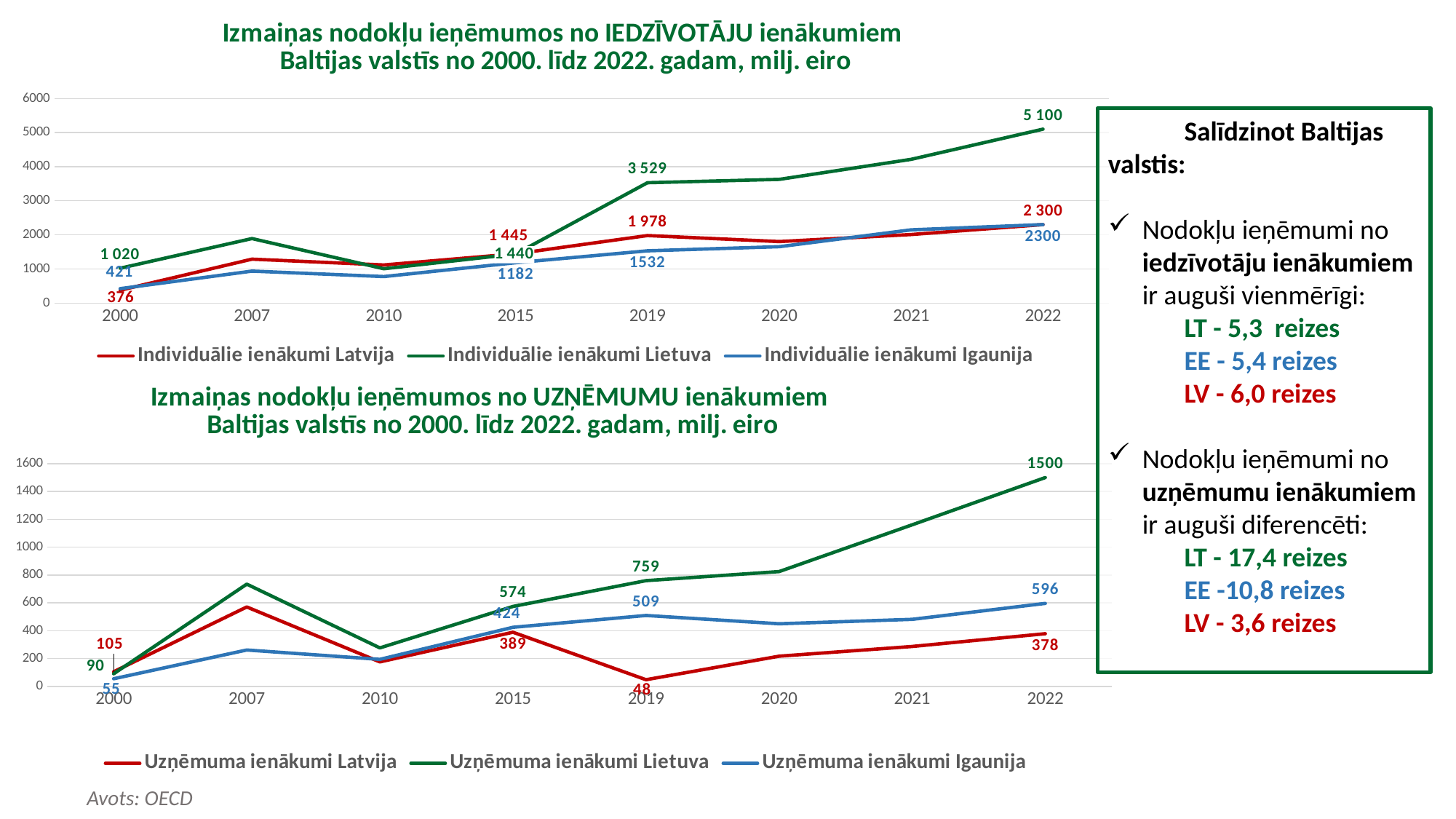
In the bottom chart (UZŅĒMUMU ienākumiem), what is the value for Uzņēmuma ienākumi Latvija in 2019? 48 In the top chart (IEDZĪVOTĀJU ienākumiem), what is the value for Individuālie ienākumi Latvija in 2019? 1 978 In the bottom chart (UZŅĒMUMU ienākumiem), which series has the lowest value in 2000? Uzņēmuma ienākumi Igaunija In the top chart (IEDZĪVOTĀJU ienākumiem), which series has the highest value in 2022? Individuālie ienākumi Lietuva What kind of chart is the top chart (IEDZĪVOTĀJU ienākumiem)? line chart In the bottom chart (UZŅĒMUMU ienākumiem), which is larger in 2015: the value for Lietuva or the value for Igaunija? Lietuva In the top chart (IEDZĪVOTĀJU ienākumiem), what is the value for Individuālie ienākumi Igaunija in 2000? 421 In the top chart (IEDZĪVOTĀJU ienākumiem), what is the value for Individuālie ienākumi Lietuva in 2022? 5 100 In the bottom chart (UZŅĒMUMU ienākumiem), what is the value for Uzņēmuma ienākumi Igaunija in 2022? 596 How many series does the legend of the bottom chart (UZŅĒMUMU ienākumiem) list? 3 In the top chart (IEDZĪVOTĀJU ienākumiem), what is the difference between the Lietuva and Latvija values in 2019? 1 551 In the top chart (IEDZĪVOTĀJU ienākumiem), is the value for Individuālie ienākumi Lietuva in 2021 greater or less than 4000? greater